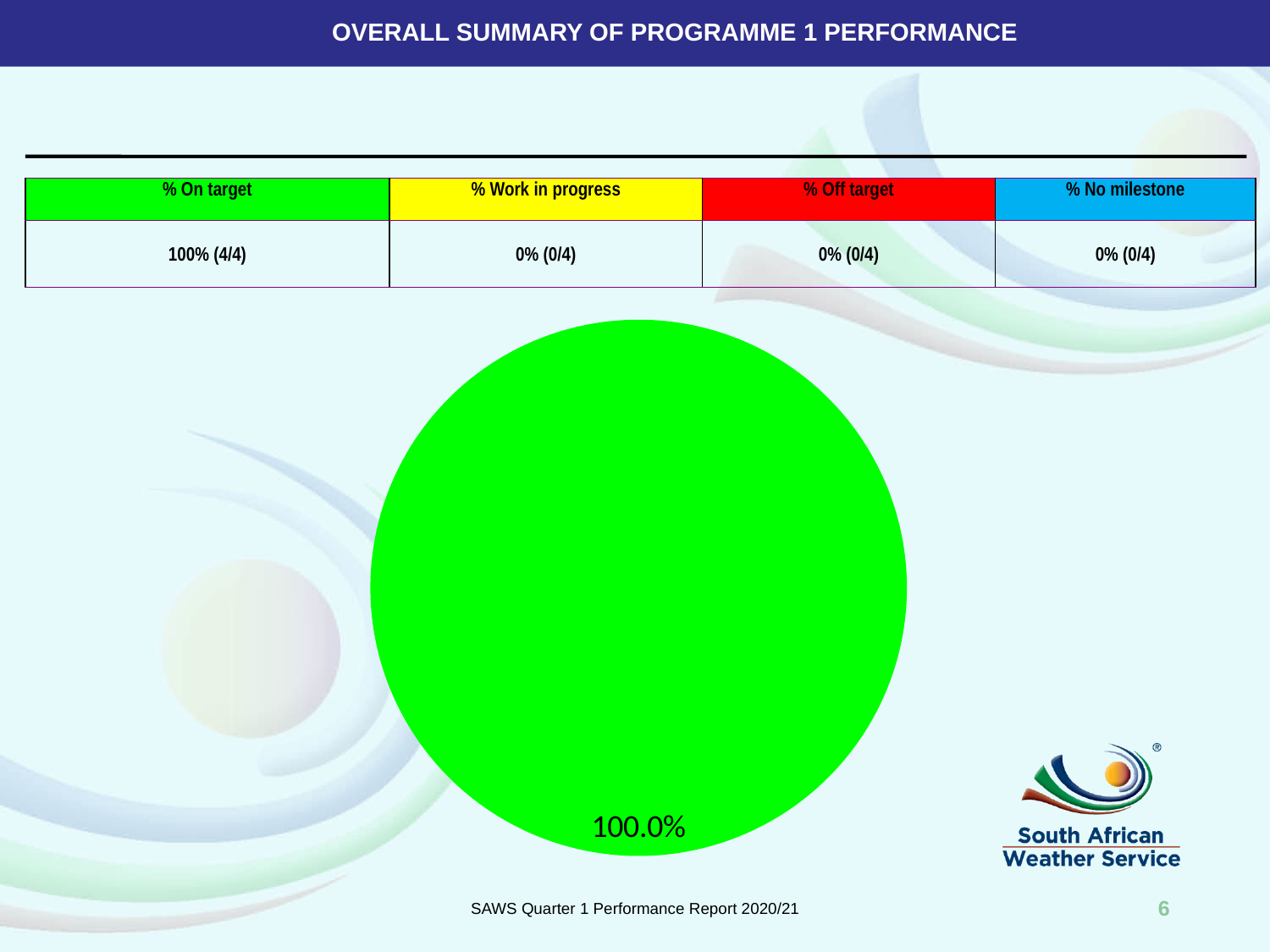
According to the colour key in the table above the chart, which category does the green slice of the pie represent? % On target What percentage is printed on the pie chart's slice? 100.0% What share of the pie does the green slice take up? 100.0% How many slices are visible in the pie chart? 1 What colour is the single slice of the pie chart? green Is the value shown on the pie chart's slice greater or less than 50%? greater What kind of chart is shown on the slide? pie chart